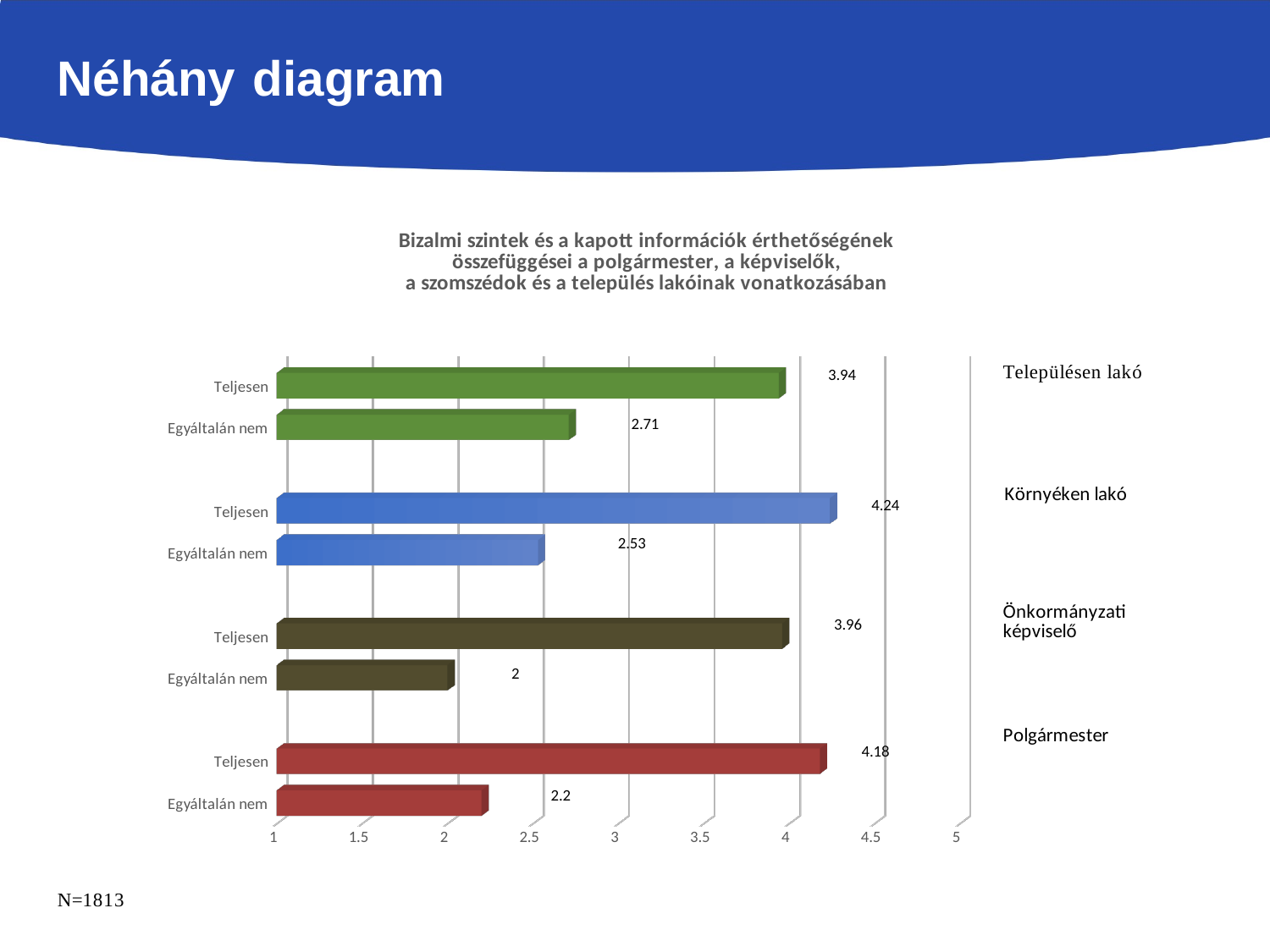
Is the "Teljesen" value for Önkormányzati képviselő greater or less than 3.5? greater How many bars are plotted in the chart? 8 What is the value of the "Teljesen" bar for Településen lakó? 3.94 What is the value of the "Egyáltalán nem" bar for Önkormányzati képviselő? 2 What is the sample size (N) stated on the slide? N=1813 What kind of chart is shown on the slide? Bar chart Which is larger: the "Egyáltalán nem" value for Településen lakó or for Környéken lakó? Településen lakó Which group has the lowest "Egyáltalán nem" value? Önkormányzati képviselő Which group has the highest "Teljesen" value? Környéken lakó What is the difference between the "Teljesen" and "Egyáltalán nem" values for Polgármester? 1.98 What is the value of the "Egyáltalán nem" bar for Környéken lakó? 2.53 What is the value of the "Teljesen" bar for Polgármester? 4.18